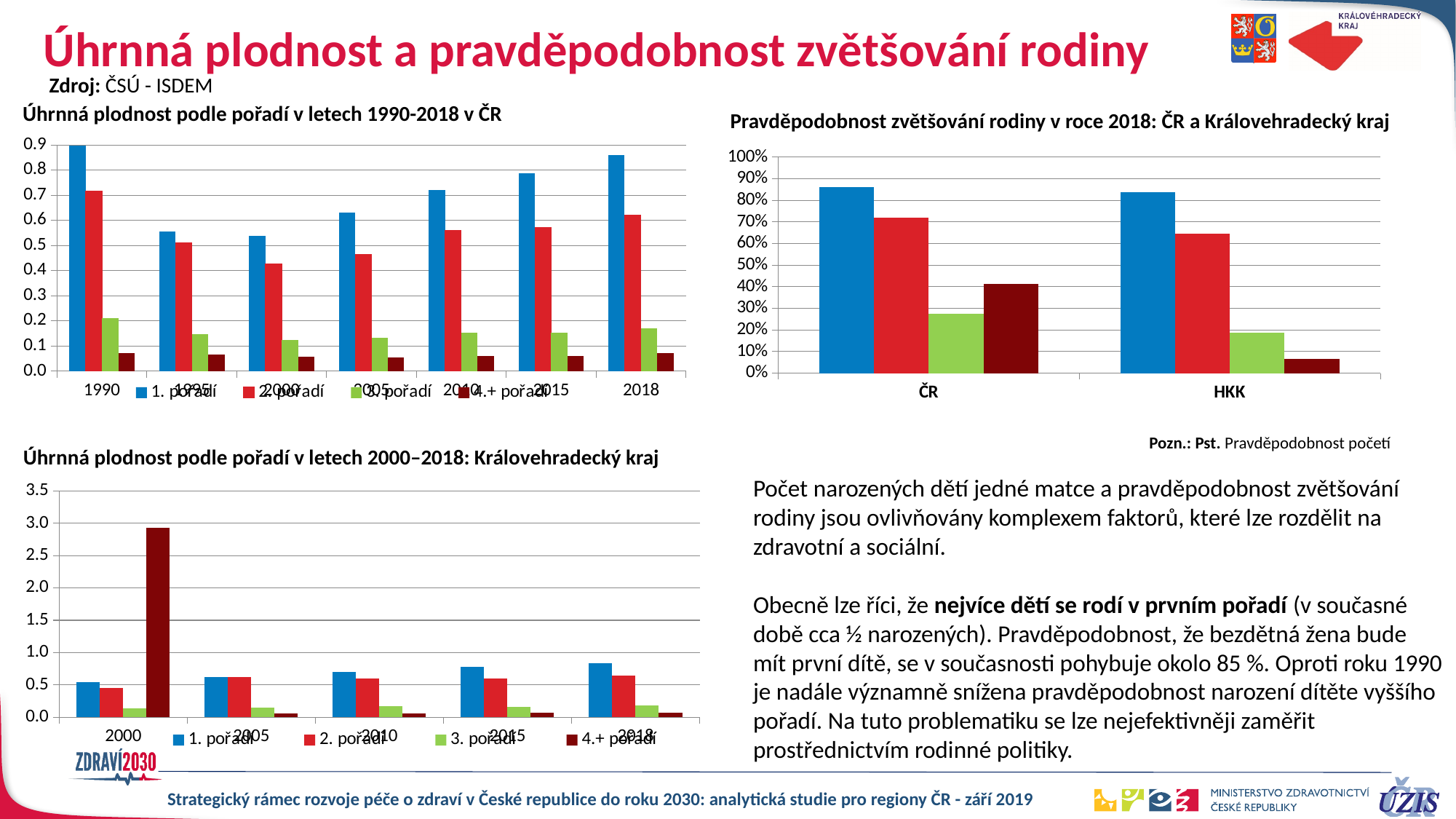
In the top-left chart (Úhrnná plodnost podle pořadí v letech 1990-2018 v ČR), is the value for 1. pořadí in 1990 greater or less than 0.8? greater In the bottom-left chart (Úhrnná plodnost podle pořadí v letech 2000–2018: Královehradecký kraj), do the values for 1. pořadí rise or fall from 2000 to 2018? rise What kind of chart is the top-left chart titled 'Úhrnná plodnost podle pořadí v letech 1990-2018 v ČR'? bar chart In the top-left chart (Úhrnná plodnost podle pořadí v letech 1990-2018 v ČR), is the value for 2. pořadí in 2000 greater or less than 0.5? less In the top-left chart (Úhrnná plodnost podle pořadí v letech 1990-2018 v ČR), which year has the highest value for 3. pořadí? 1990 In the top-left chart (Úhrnná plodnost podle pořadí v letech 1990-2018 v ČR), how many series does the legend list? 4 In the top-left chart (Úhrnná plodnost podle pořadí v letech 1990-2018 v ČR), how many years are shown on the x axis? 7 In the bottom-left chart (Úhrnná plodnost podle pořadí v letech 2000–2018: Královehradecký kraj), which year has the highest value for 4.+ pořadí? 2000 In the top-right chart (Pravděpodobnost zvětšování rodiny v roce 2018: ČR a Královehradecký kraj), which is larger: the green bar for ČR or the green bar for HKK? ČR In the top-right chart (Pravděpodobnost zvětšování rodiny v roce 2018: ČR a Královehradecký kraj), how many categories are shown on the x axis? 2 In the top-right chart (Pravděpodobnost zvětšování rodiny v roce 2018: ČR a Královehradecký kraj), is the blue bar for ČR greater or less than 80%? greater In the top-left chart (Úhrnná plodnost podle pořadí v letech 1990-2018 v ČR), which is larger: the 1. pořadí value in 2005 or in 2010? 2010